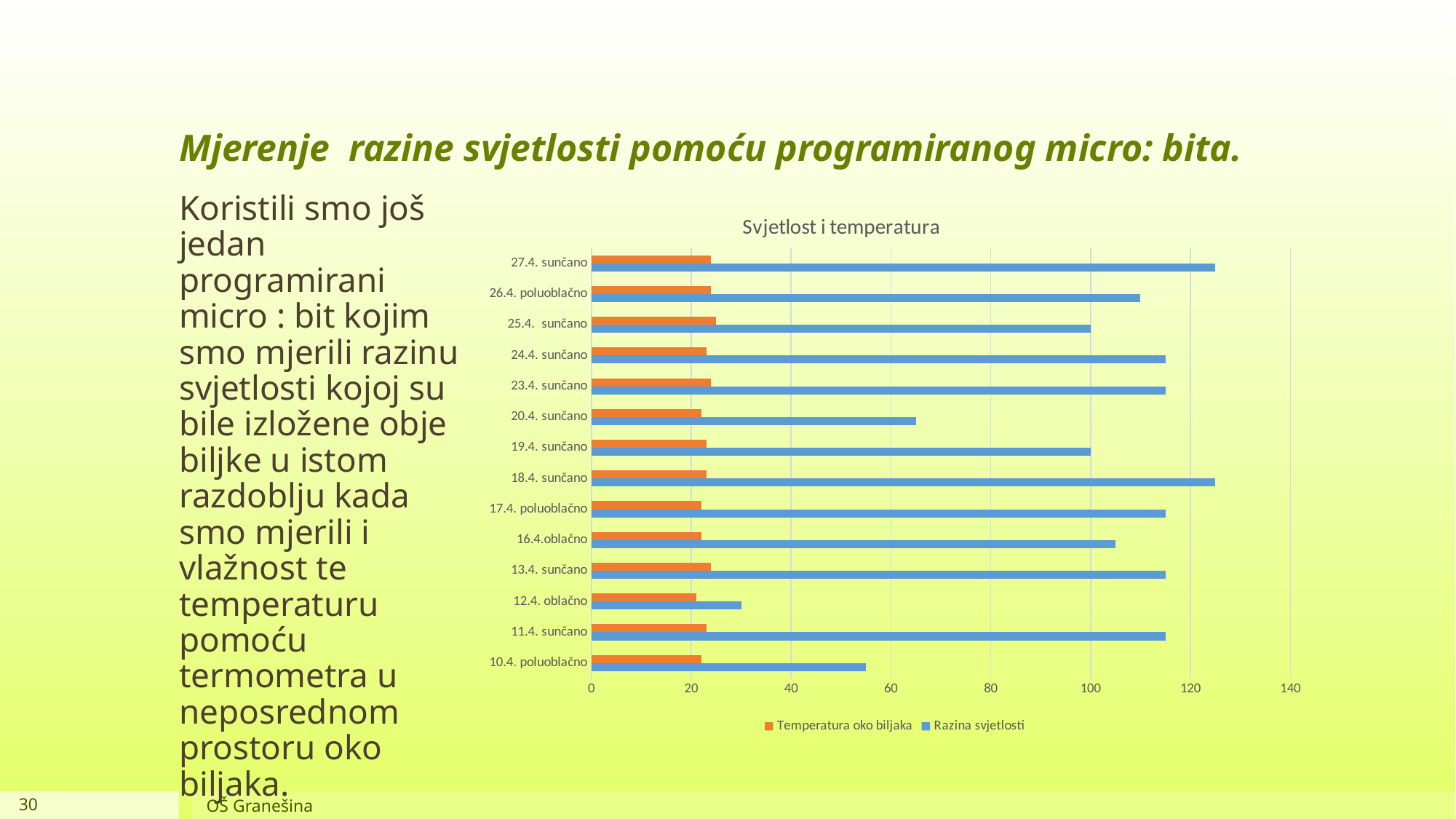
Is the Razina svjetlosti value for 27.4. sunčano greater or less than 120? greater Is the Razina svjetlosti value for 10.4. poluoblačno greater or less than 60? less How many series does the chart legend list? 2 Which has the larger Razina svjetlosti value, 26.4. poluoblačno or 20.4. sunčano? 26.4. poluoblačno Which category has the lowest Razina svjetlosti value? 12.4. oblačno Which series is shown in orange in the chart? Temperatura oko biljaka How many date categories are plotted on the chart? 14 Is the Temperatura oko biljaka value for 13.4. sunčano greater or less than 40? less Which has the larger Razina svjetlosti value, 20.4. sunčano or 12.4. oblačno? 20.4. sunčano What is the title of the chart? Svjetlost i temperatura What kind of chart is shown on the slide? bar chart